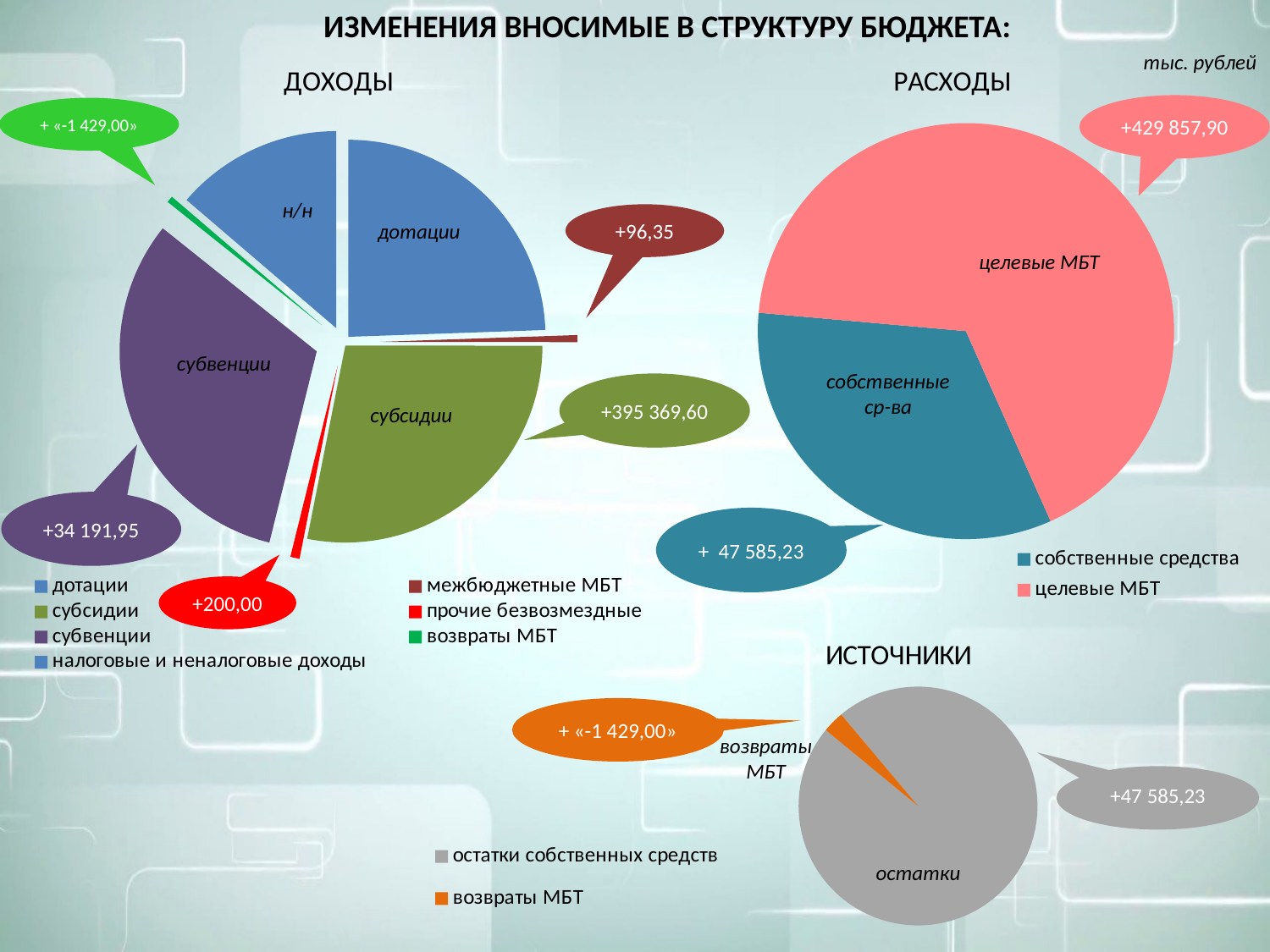
What kind of chart is the ДОХОДЫ chart? pie chart How many entries does the legend of the РАСХОДЫ chart list? 2 How many slices does the ИСТОЧНИКИ chart have? 2 In the ИСТОЧНИКИ chart, which slice is the smallest? возвраты МБТ In the ДОХОДЫ chart, which slice is larger: дотации or н/н? дотации What unit is stated at the top right of the slide for the values? тыс. рублей In the РАСХОДЫ chart, what change value is shown in the callout pointing to the целевые МБТ slice? +429 857,90 How many entries does the legend of the ДОХОДЫ chart list? 7 In the РАСХОДЫ chart, which slice is the largest? целевые МБТ In the ДОХОДЫ chart, which slice is larger: субвенции or возвраты МБТ? субвенции In the ИСТОЧНИКИ chart, what change value is shown in the callout pointing to the остатки slice? +47 585,23 In the ДОХОДЫ chart, what change value is shown in the callout pointing to the субсидии slice? +395 369,60